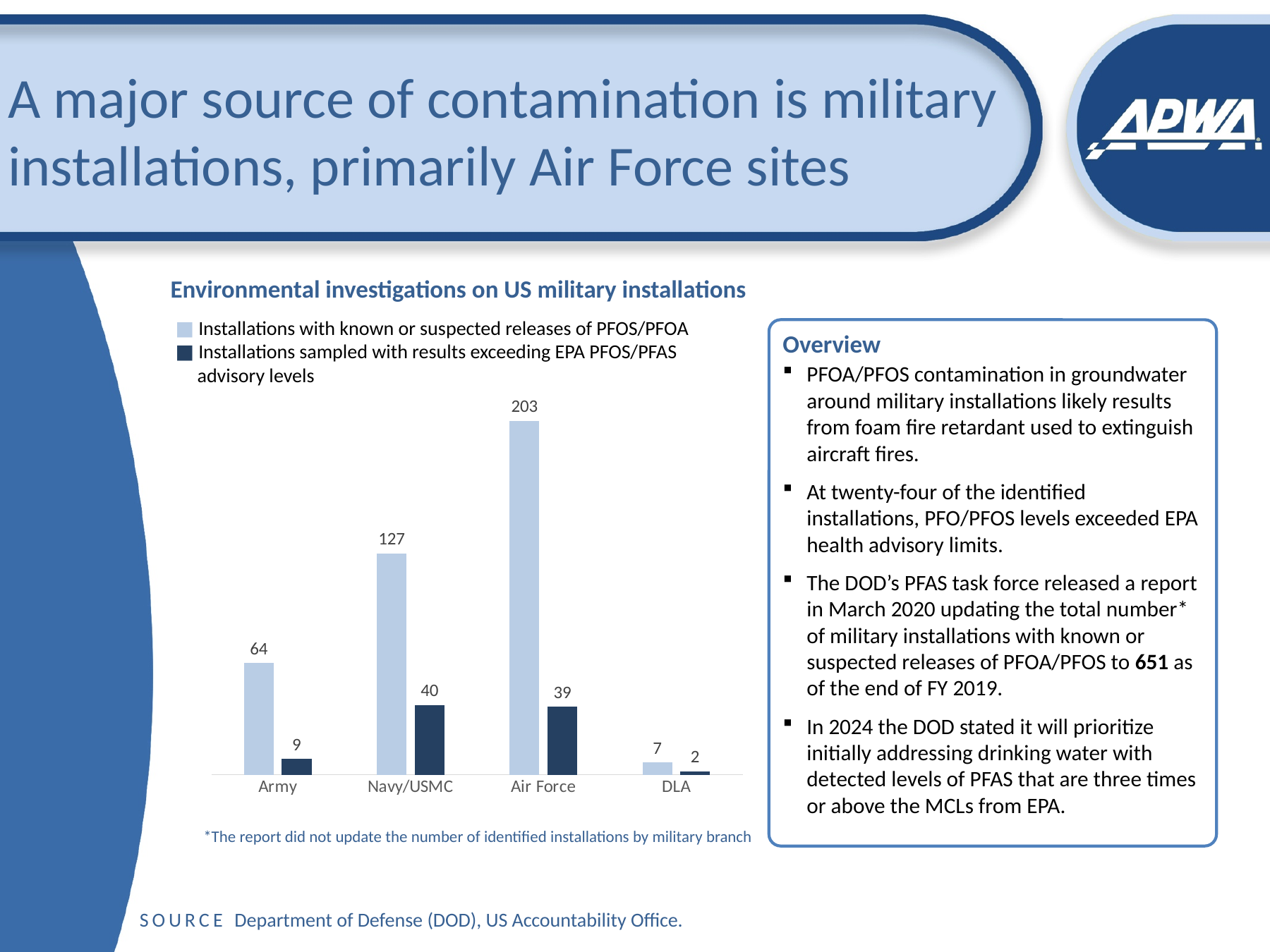
What is the difference between the Air Force and Navy/USMC values for installations with known or suspected releases of PFOS/PFOA? 76 Which military branch has the lowest number of installations sampled with results exceeding EPA advisory levels? DLA Which military branch has the highest number of installations with known or suspected releases of PFOS/PFOA? Air Force How many military branches are shown on the x axis of the chart? 4 What type of chart is used to show environmental investigations on US military installations? Bar chart What is the value for DLA installations with known or suspected releases of PFOS/PFOA? 7 What is the difference between the Army's installations with known or suspected releases and its installations sampled with results exceeding advisory levels? 55 What is the title of the chart? Environmental investigations on US military installations What is the number of installations with known or suspected releases of PFOS/PFOA for the Air Force? 203 How many Navy/USMC installations were sampled with results exceeding EPA PFOS/PFAS advisory levels? 40 Which is larger: the Army's installations with known or suspected releases (64) or the Navy/USMC's installations sampled with results exceeding advisory levels (40)? Army's installations with known or suspected releases (64) How many series does the chart legend list? 2